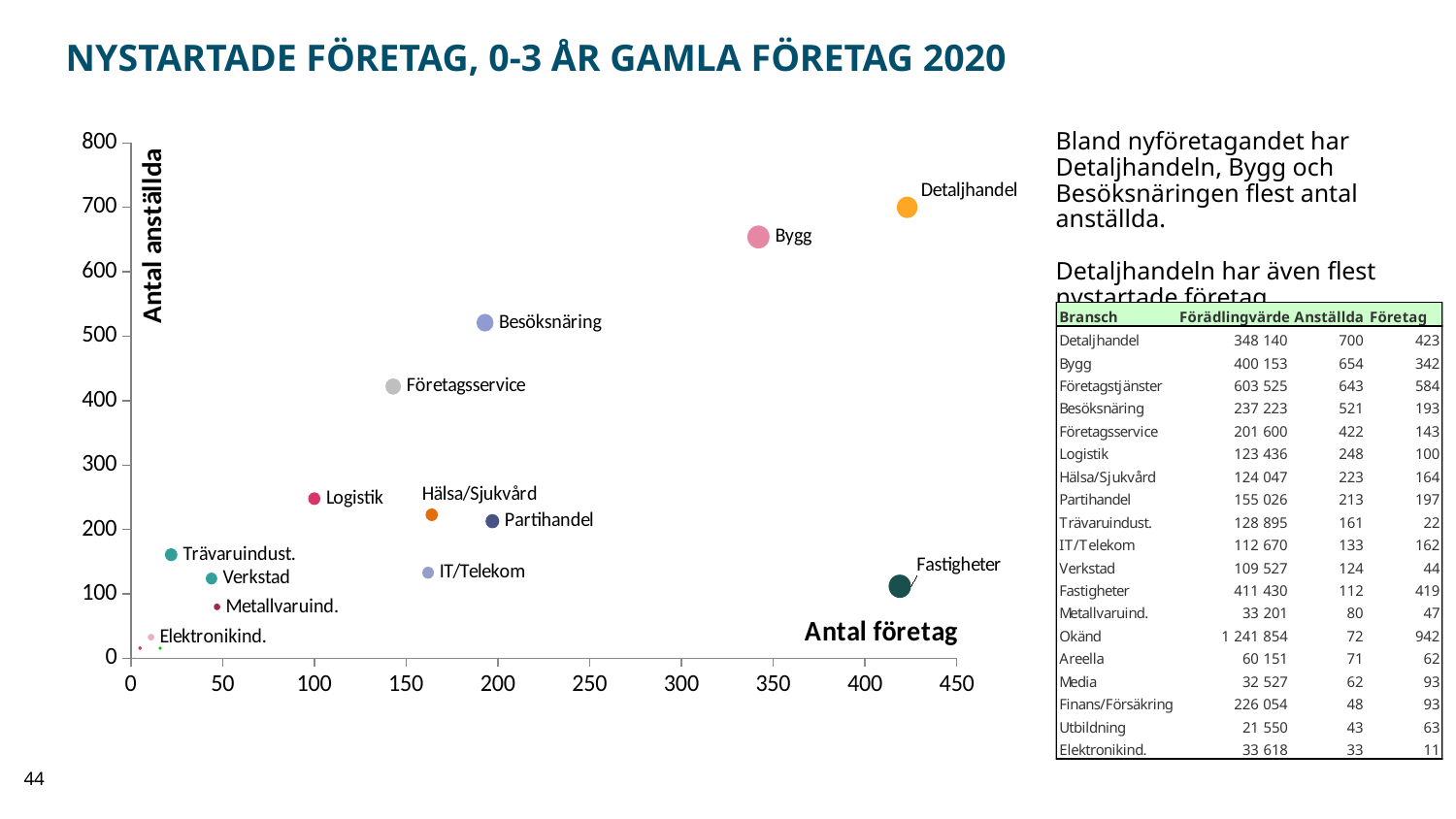
What is the label of the vertical axis of the chart? Antal anställda Is the Antal företag value for Fastigheter greater or less than 400? greater Which has more Antal anställda, Bygg or Besöksnäring? Bygg What kind of chart is shown on the slide? bubble chart What is the difference in Anställda between Detaljhandel and Bygg according to the table? 46 According to the table, what is the Förädlingsvärde for Besöksnäring? 237 223 Which labeled bubble has the highest Antal anställda? Detaljhandel What is the label of the horizontal axis of the chart? Antal företag According to the table, how many Företag does Bygg have? 342 Which labeled bubble has the lowest Antal anställda? Elektronikind. According to the table, how many Anställda does Detaljhandel have? 700 Is the Antal anställda value for Besöksnäring greater or less than 500? greater